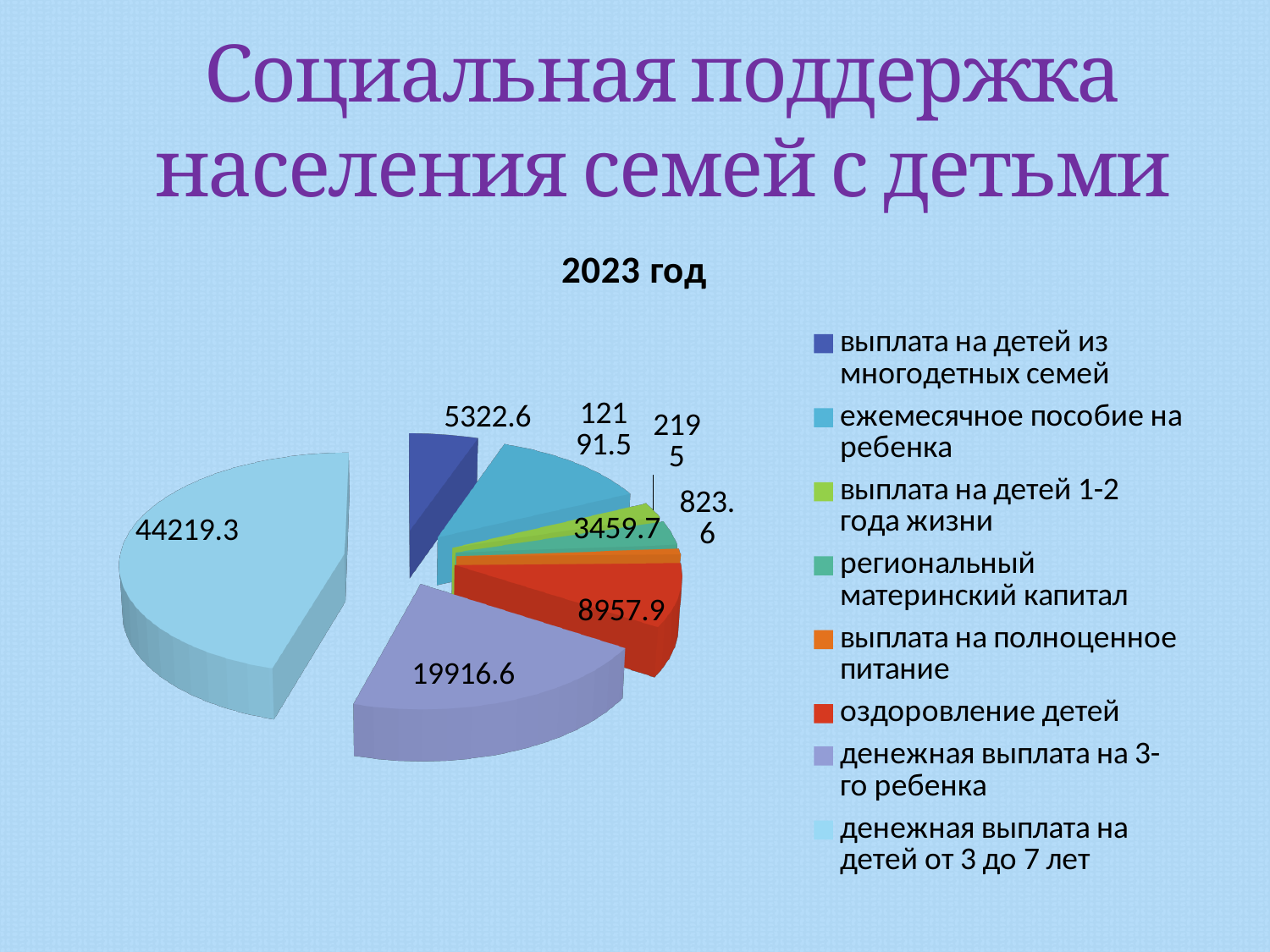
What kind of chart is shown on the slide? pie chart What is the difference between the values for "денежная выплата на 3-го ребенка" and "оздоровление детей"? 10958.7 Which category has the smallest slice of the pie? выплата на полноценное питание Which category has the largest slice of the pie? денежная выплата на детей от 3 до 7 лет What is the value for "денежная выплата на 3-го ребенка"? 19916.6 How many categories does the pie chart have? 8 What is the title of the chart? 2023 год What is the value for "денежная выплата на детей от 3 до 7 лет"? 44219.3 What is the value for "ежемесячное пособие на ребенка"? 12191.5 Which is larger: "ежемесячное пособие на ребенка" or "оздоровление детей"? ежемесячное пособие на ребенка What is the value for "выплата на детей из многодетных семей"? 5322.6 What is the value for "оздоровление детей"? 8957.9